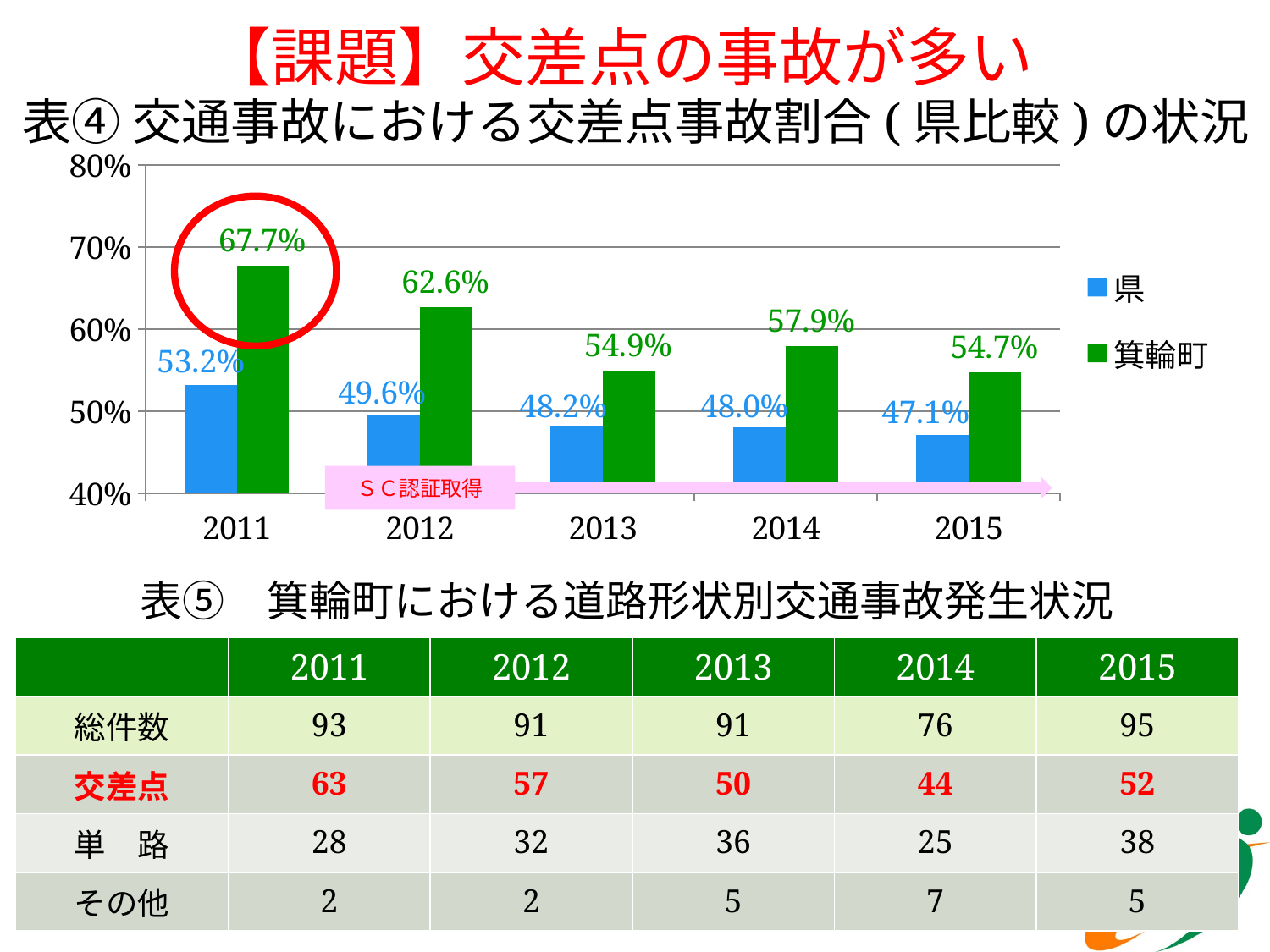
In the chart 表④, what is the value for 箕輪町 in 2014? 57.9% In the chart 表④, which is larger in 2013, the value for 県 or for 箕輪町? 箕輪町 In the chart 表④, which year has the lowest value for 県? 2015 In the chart 表④, which year has the highest value for 箕輪町? 2011 How many years are shown on the x axis of the chart 表④? 5 In the chart 表④, what is the difference between the 箕輪町 and 県 values in 2012? 13.0% In the chart 表④, is the value for 箕輪町 in 2015 greater or less than 60%? less What type of chart is shown in 表④? bar chart In the chart 表④, what is the value for 箕輪町 in 2011? 67.7% In the chart 表④, what is the value for 県 in 2015? 47.1% In the chart 表④, do the values for 県 rise or fall from 2011 to 2015? fall How many series does the legend of the chart 表④ list? 2